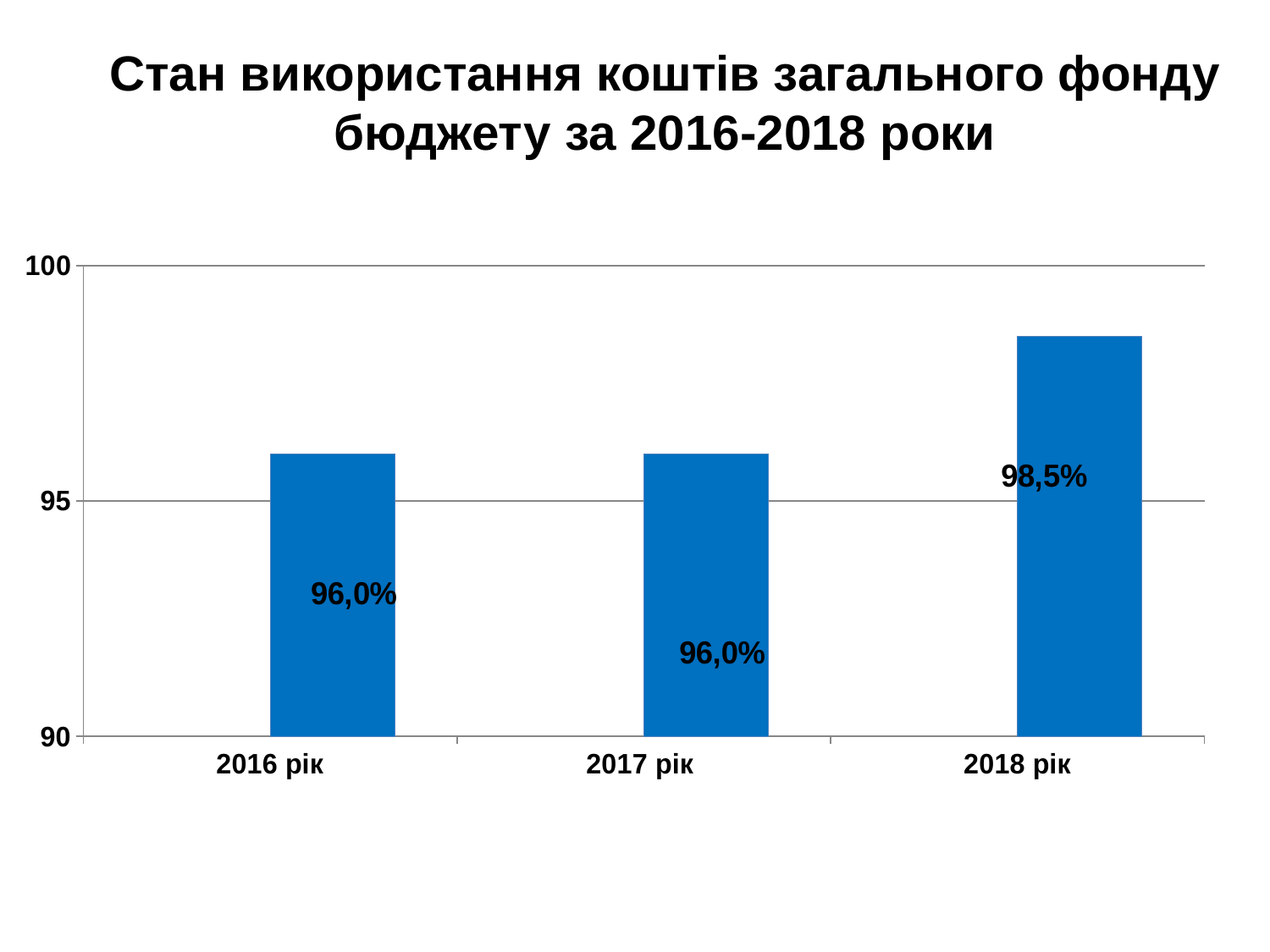
What is the title of the slide? Стан використання коштів загального фонду бюджету за 2016-2018 роки Is the value for 2018 рік greater or less than 95? greater Which is larger, the value for 2018 рік or the value for 2016 рік? 2018 рік What is the difference between the values for 2018 рік and 2017 рік? 2,5% What is the value for 2017 рік? 96,0% How many categories are shown on the x axis? 3 What is the value for 2018 рік? 98,5% What is the value for 2016 рік? 96,0% What kind of chart is shown on the slide? bar chart Which year has the highest value? 2018 рік Are the values for 2016 рік and 2017 рік the same? yes Do the values rise or fall from 2017 рік to 2018 рік? rise